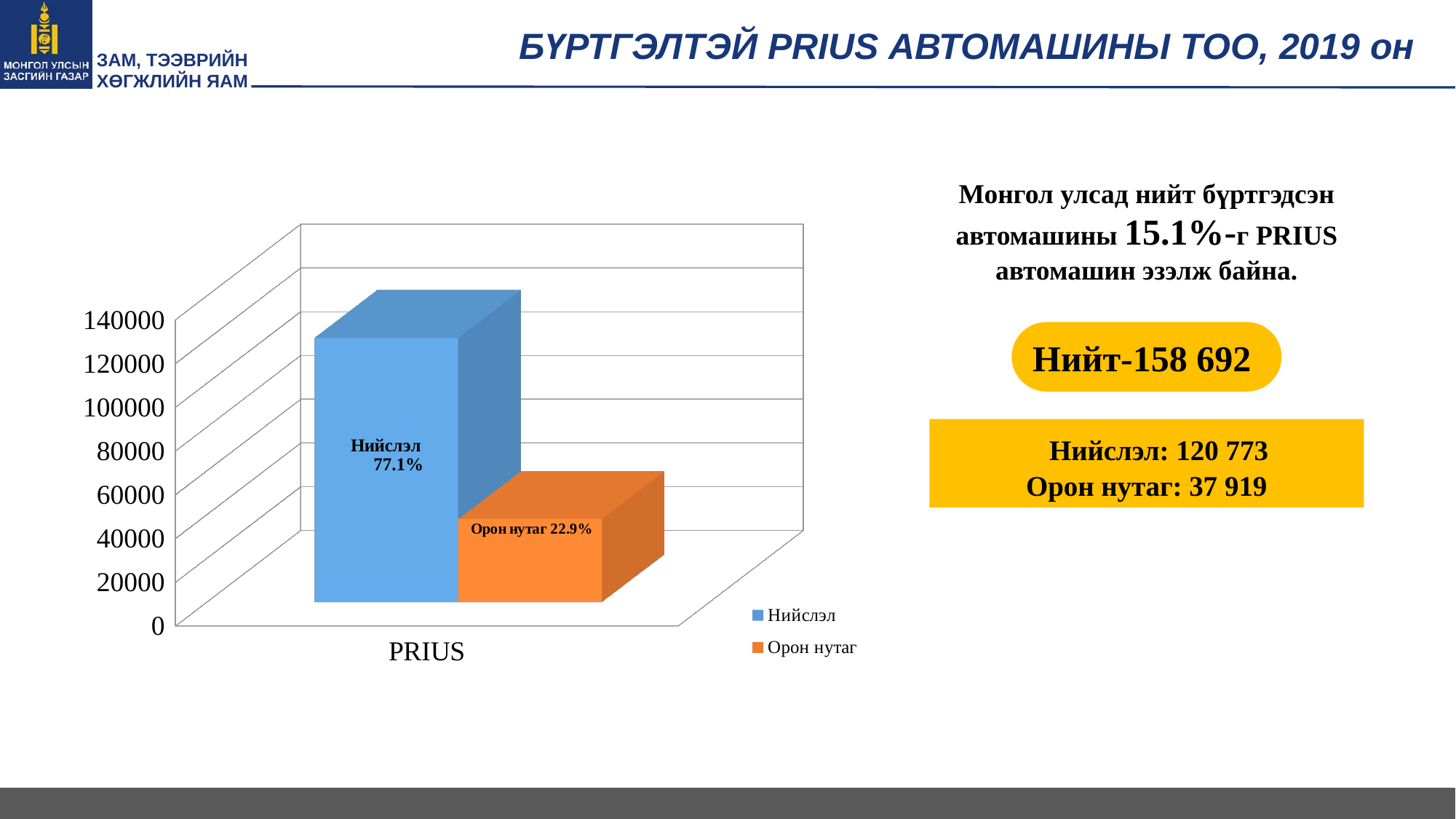
What is the category label on the x axis? PRIUS How many series does the legend list? 2 Is the value for Орон нутаг greater or less than 60000? less What percentage label is shown on the Орон нутаг bar? 22.9% Is the value for Нийслэл greater or less than 100000? greater What colour is the Орон нутаг bar? Orange Which series has the lowest value in the chart? Орон нутаг Which series has the taller bar, Нийслэл or Орон нутаг? Нийслэл What kind of chart is shown on the slide? Bar chart Which series has the highest value in the chart? Нийслэл What percentage label is shown on the Нийслэл bar? 77.1% How many categories are shown on the x axis? 1